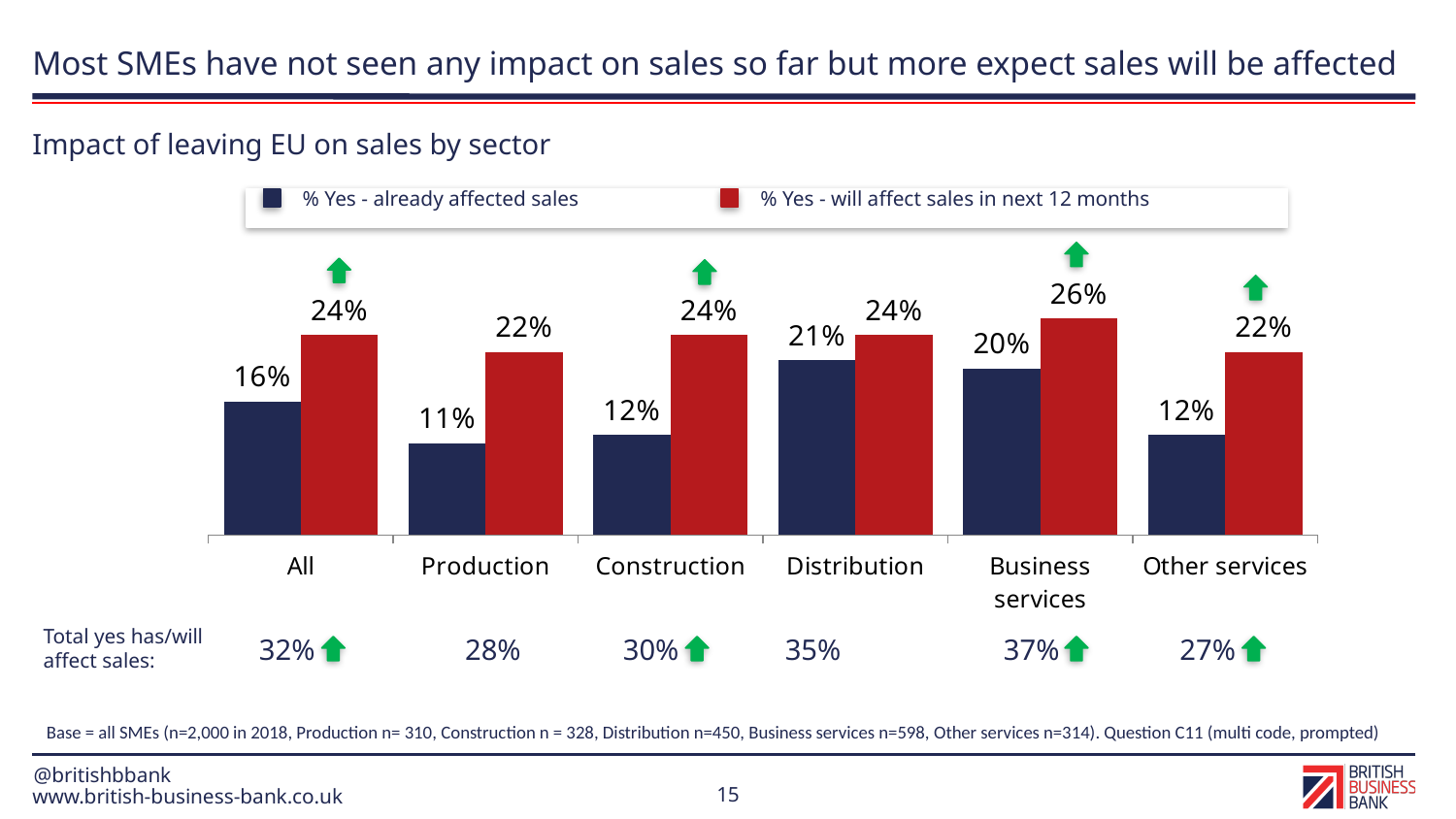
What is the difference between the two series for Construction? 12% What is the chart's title? Impact of leaving EU on sales by sector Which category has the highest value in the '% Yes - will affect sales in next 12 months' series? Business services Which is larger for Other services: '% Yes - already affected sales' or '% Yes - will affect sales in next 12 months'? % Yes - will affect sales in next 12 months What is the value for Business services in the '% Yes - will affect sales in next 12 months' series? 26% Which category has the lowest value in the '% Yes - already affected sales' series? Production How many series does the legend list? 2 How many categories are shown on the x axis? 6 What colour are the bars for the '% Yes - will affect sales in next 12 months' series? Red What kind of chart is shown on the slide? Bar chart What is the value for Distribution in the '% Yes - already affected sales' series? 21% What is the value for Production in the '% Yes - already affected sales' series? 11%